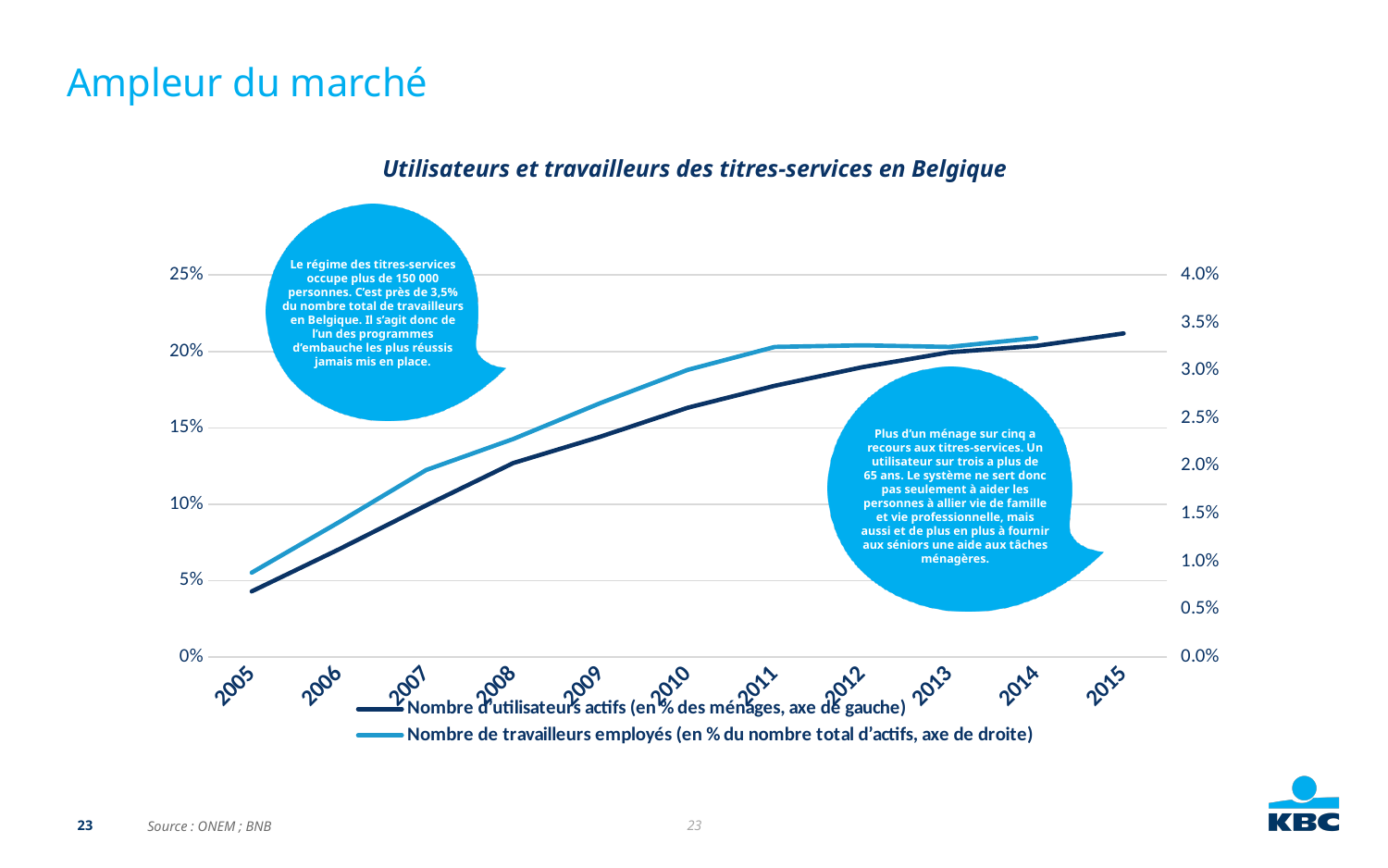
Does the 'Nombre d'utilisateurs actifs' line rise or fall from 2005 to 2015? rise Is the value for 'Nombre d'utilisateurs actifs' in 2015 greater or less than 20%? greater Does the 'Nombre de travailleurs employés' line rise or fall from 2005 to 2014? rise How many series does the legend list? 2 Is the value for 'Nombre d'utilisateurs actifs' in 2005 greater or less than 5%? less Is the value for 'Nombre de travailleurs employés' in 2007 greater or less than 1.5%? greater How many years are shown on the x axis? 11 What is the title of the chart? Utilisateurs et travailleurs des titres-services en Belgique Which series is plotted against the right-hand axis according to the legend? Nombre de travailleurs employés (en % du nombre total d'actifs, axe de droite) What kind of chart is shown on the slide? line chart